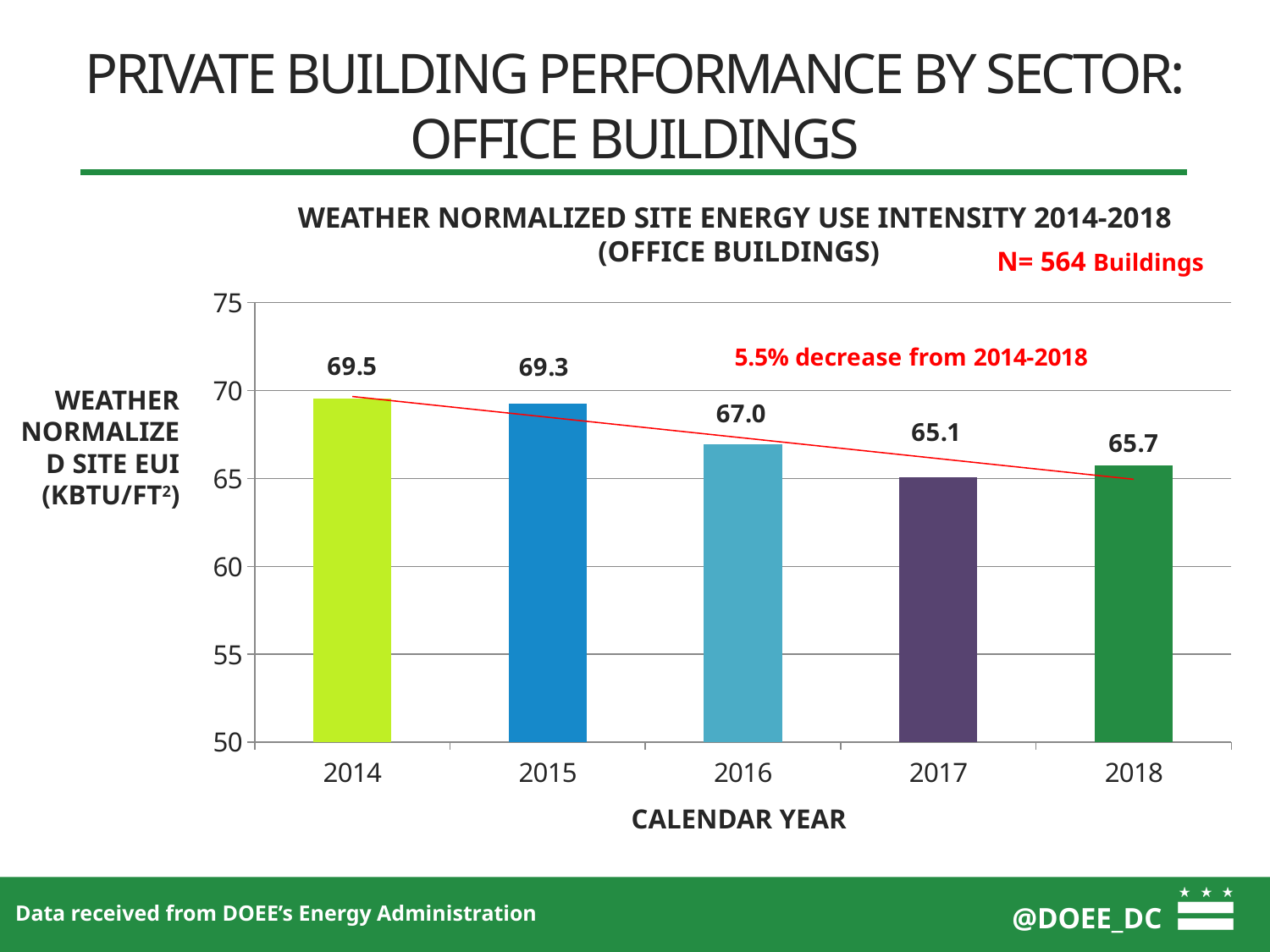
What is the weather normalized site EUI for office buildings in 2014? 69.5 Does the weather normalized site EUI generally rise or fall from 2014 to 2018? Fall Which year has a higher weather normalized site EUI, 2016 or 2018? 2016 What kind of chart is shown on the slide? Bar chart Which calendar year has the highest weather normalized site EUI? 2014 What is the weather normalized site EUI for office buildings in 2017? 65.1 What is the difference between the 2014 and 2018 weather normalized site EUI values? 3.8 What is the weather normalized site EUI for office buildings in 2018? 65.7 How many buildings does the chart's N value indicate? 564 Is the value for 2017 greater or less than 65? greater Which calendar year has the lowest weather normalized site EUI? 2017 How many calendar years are shown on the chart? 5